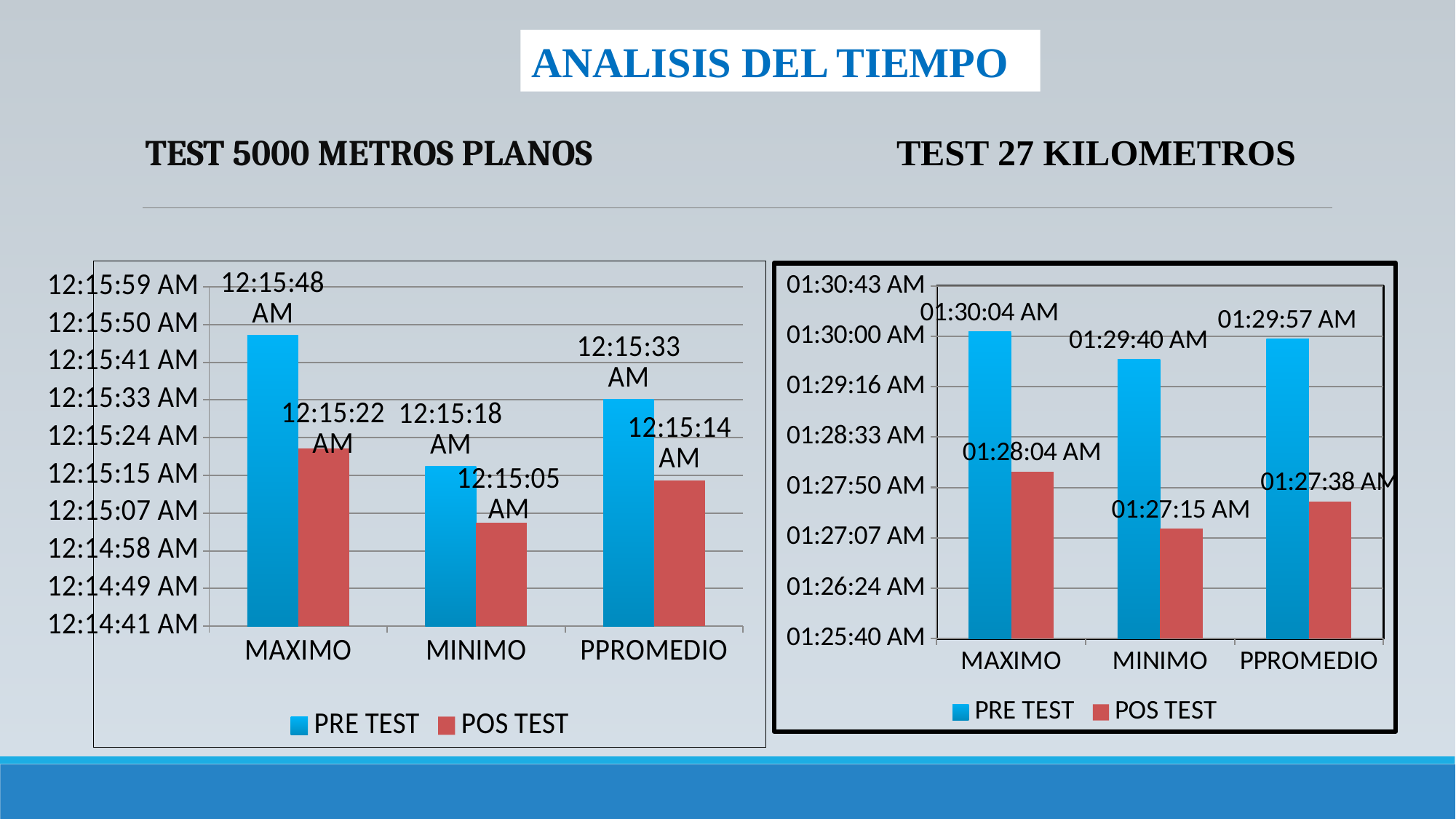
What type of chart is the TEST 5000 METROS PLANOS chart? Bar chart In the TEST 5000 METROS PLANOS chart, what is the POS TEST value for PPROMEDIO? 12:15:14 AM In the TEST 27 KILOMETROS chart, what is the POS TEST value for MAXIMO? 01:28:04 AM In the TEST 27 KILOMETROS chart, is the PRE TEST or the POS TEST value larger for PPROMEDIO? PRE TEST How many series does the legend of the TEST 27 KILOMETROS chart list? 2 In the TEST 27 KILOMETROS chart, which category has the lowest POS TEST value? MINIMO In the TEST 27 KILOMETROS chart, what is the POS TEST value for PPROMEDIO? 01:27:38 AM In the TEST 27 KILOMETROS chart, what is the PRE TEST value for MINIMO? 01:29:40 AM In the TEST 5000 METROS PLANOS chart, how many seconds separate the PRE TEST and POS TEST values for MAXIMO? 26 seconds In the TEST 5000 METROS PLANOS chart, what is the POS TEST value for MINIMO? 12:15:05 AM In the TEST 5000 METROS PLANOS chart, which category has the highest PRE TEST value? MAXIMO In the TEST 5000 METROS PLANOS chart, what is the PRE TEST value for MAXIMO? 12:15:48 AM